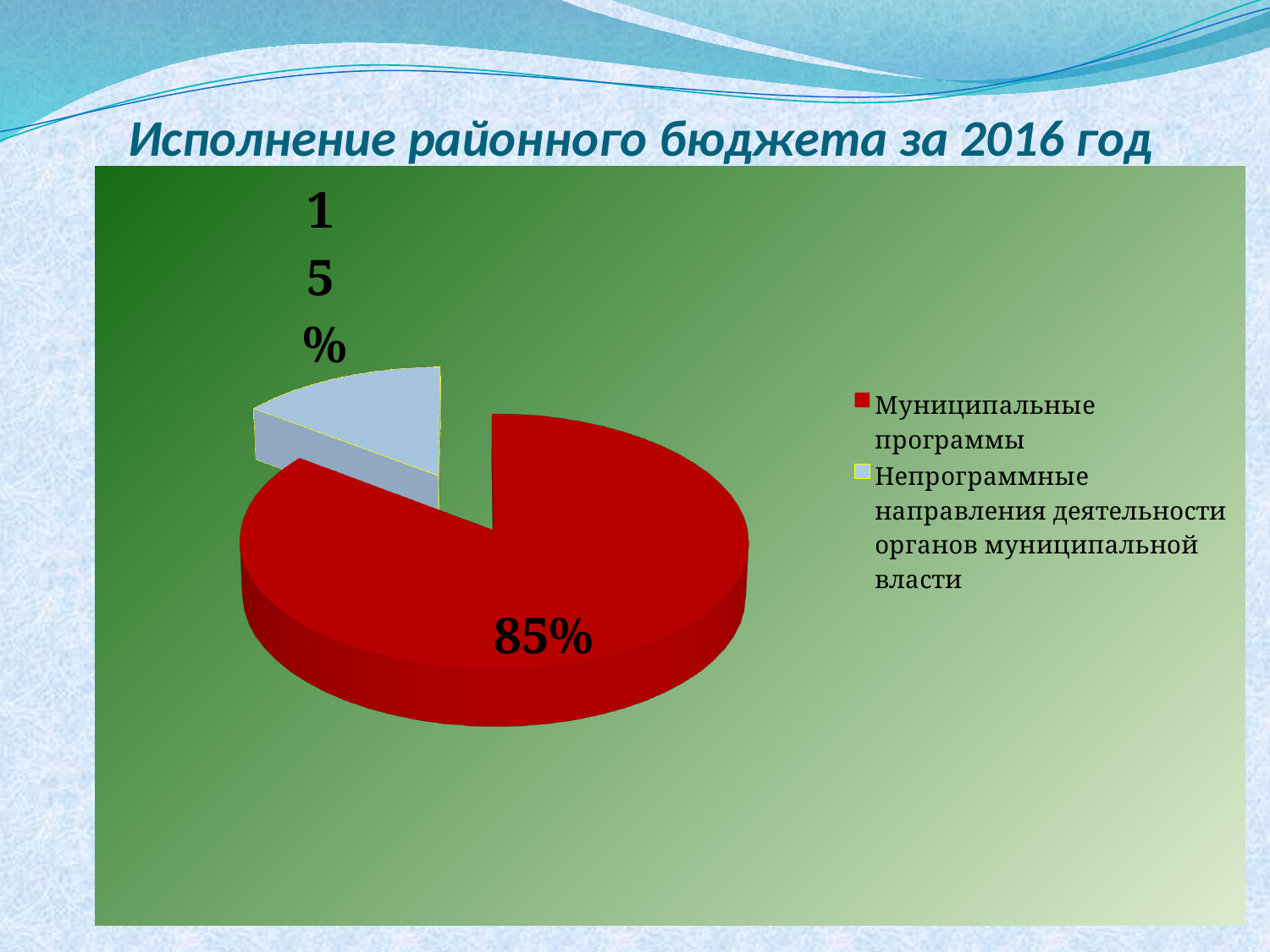
What is the title of the slide? Исполнение районного бюджета за 2016 год What colour is the slice for "Муниципальные программы"? red What share of the pie does "Муниципальные программы" represent? 85% Which is larger: the slice for "Муниципальные программы" or the slice for "Непрограммные направления деятельности органов муниципальной власти"? Муниципальные программы How many entries does the legend list? 2 What kind of chart is shown on the slide? pie chart Which category has the largest slice of the pie? Муниципальные программы What is the difference in percentage points between the "Муниципальные программы" slice and the "Непрограммные направления деятельности органов муниципальной власти" slice? 70 What share of the pie does "Непрограммные направления деятельности органов муниципальной власти" represent? 15% Which category has the smallest slice of the pie? Непрограммные направления деятельности органов муниципальной власти How many slices does the pie chart have? 2